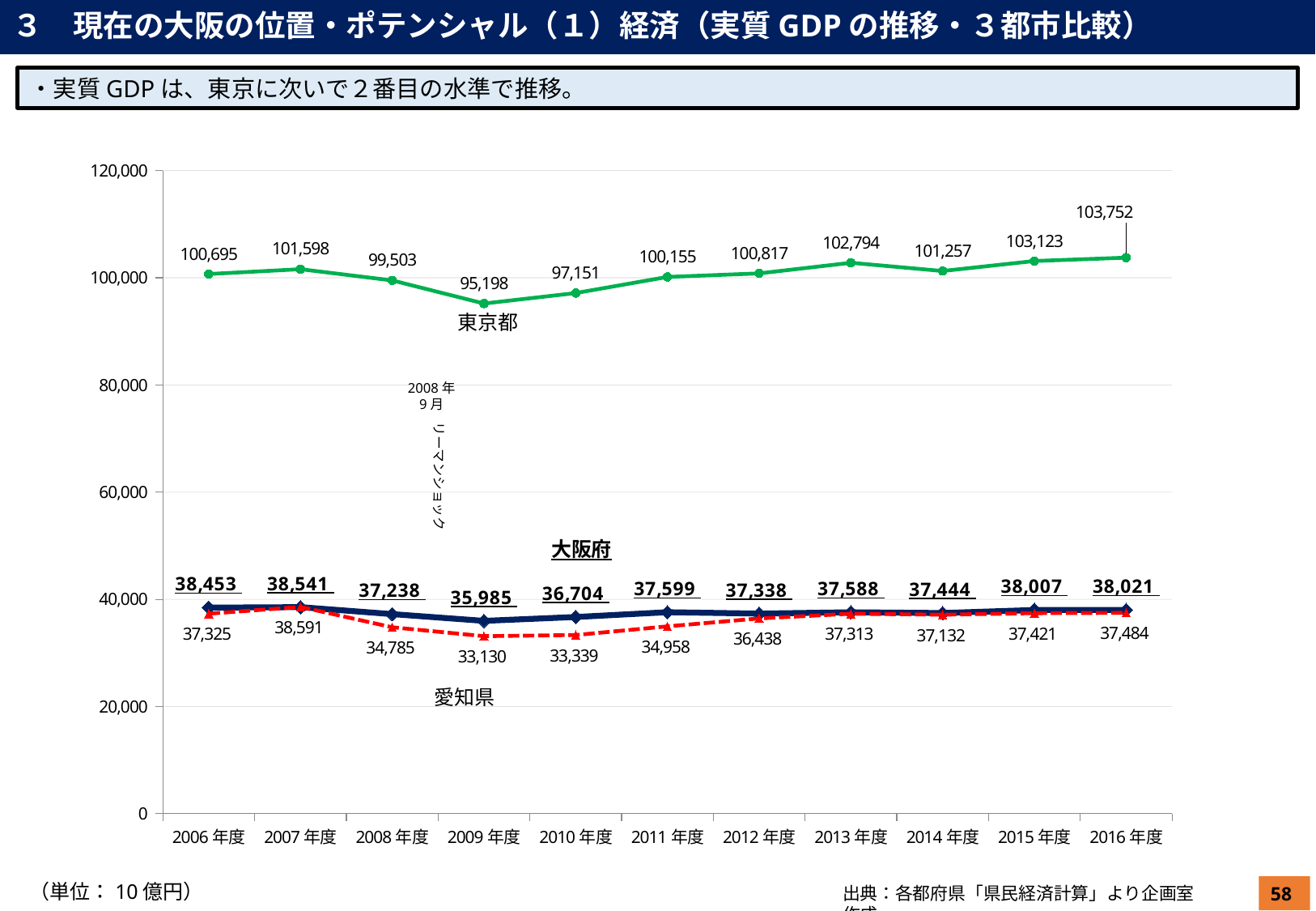
In which year does 愛知県 have its lowest value? 2009年度 In which year does 大阪府 have its lowest value? 2009年度 What kind of chart is shown on the slide? line chart What is the value for 愛知県 in 2008年度? 34,785 In 2007年度, which is larger: the value for 大阪府 or for 愛知県? 愛知県 What is the difference between the 東京都 values for 2016年度 and 2006年度? 3,057 What is the difference between the 大阪府 and 愛知県 values in 2009年度? 2,855 How many series (prefectures) are plotted on the chart? 3 What is the value for 東京都 in 2009年度? 95,198 How many fiscal years are shown on the x axis? 11 What is the value for 大阪府 in 2016年度? 38,021 In which year does 東京都 reach its highest value? 2016年度